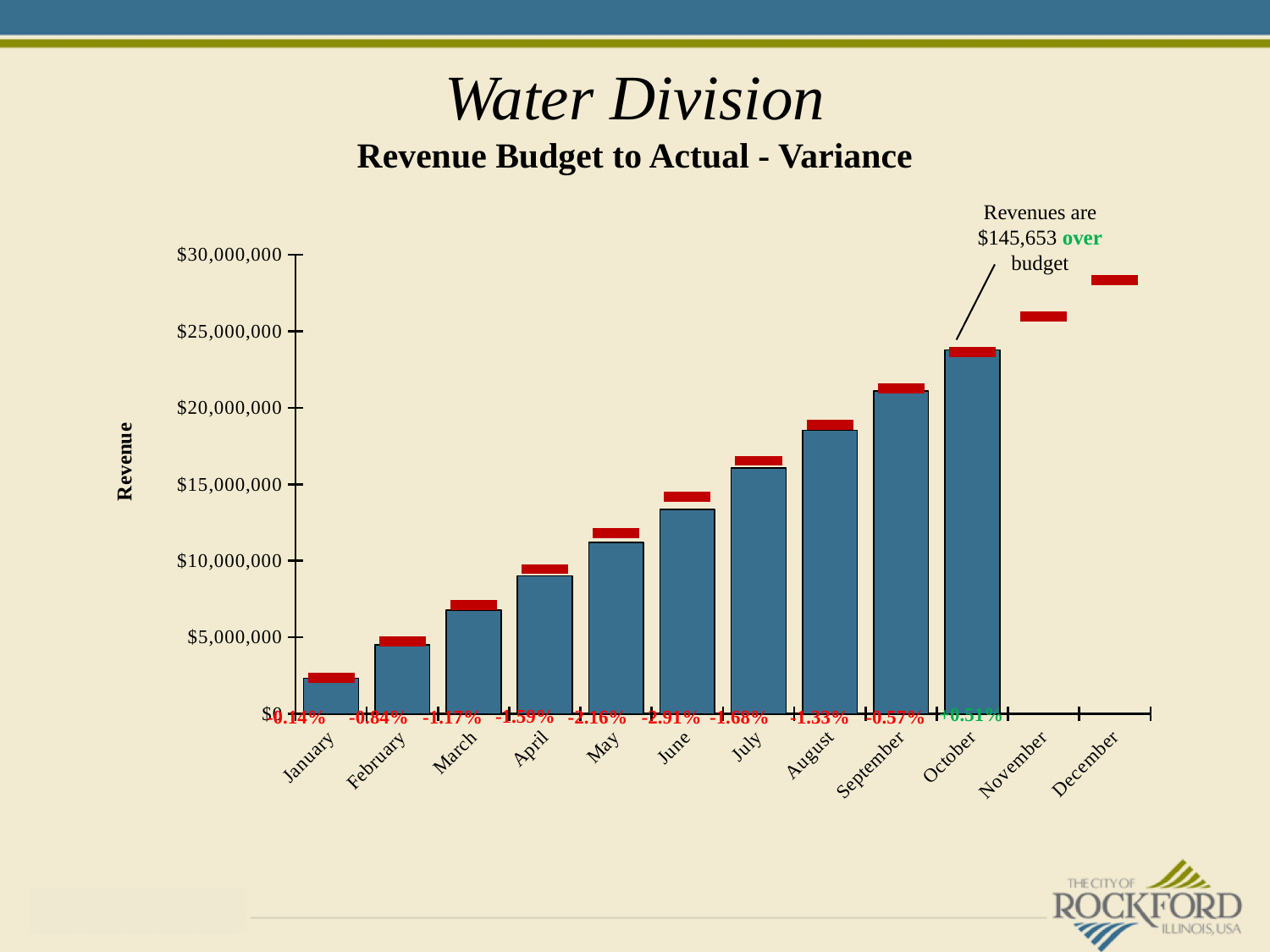
Which month has the larger revenue bar, August or April? August Is the revenue bar for October greater or less than $20,000,000? greater How many months have a revenue bar plotted on the chart? 10 Do the revenue bars rise or fall from January to October? rise What variance percentage is printed for October? +0.51% According to the annotation on the chart, by how much are revenues over budget? $145,653 How many months are labelled along the x axis of the chart? 12 Is the revenue bar for May greater or less than $15,000,000? less What variance percentage is printed for June? -2.91% Which month has the tallest revenue bar? October What kind of chart is shown on the slide? Bar chart Which month has the shortest revenue bar? January